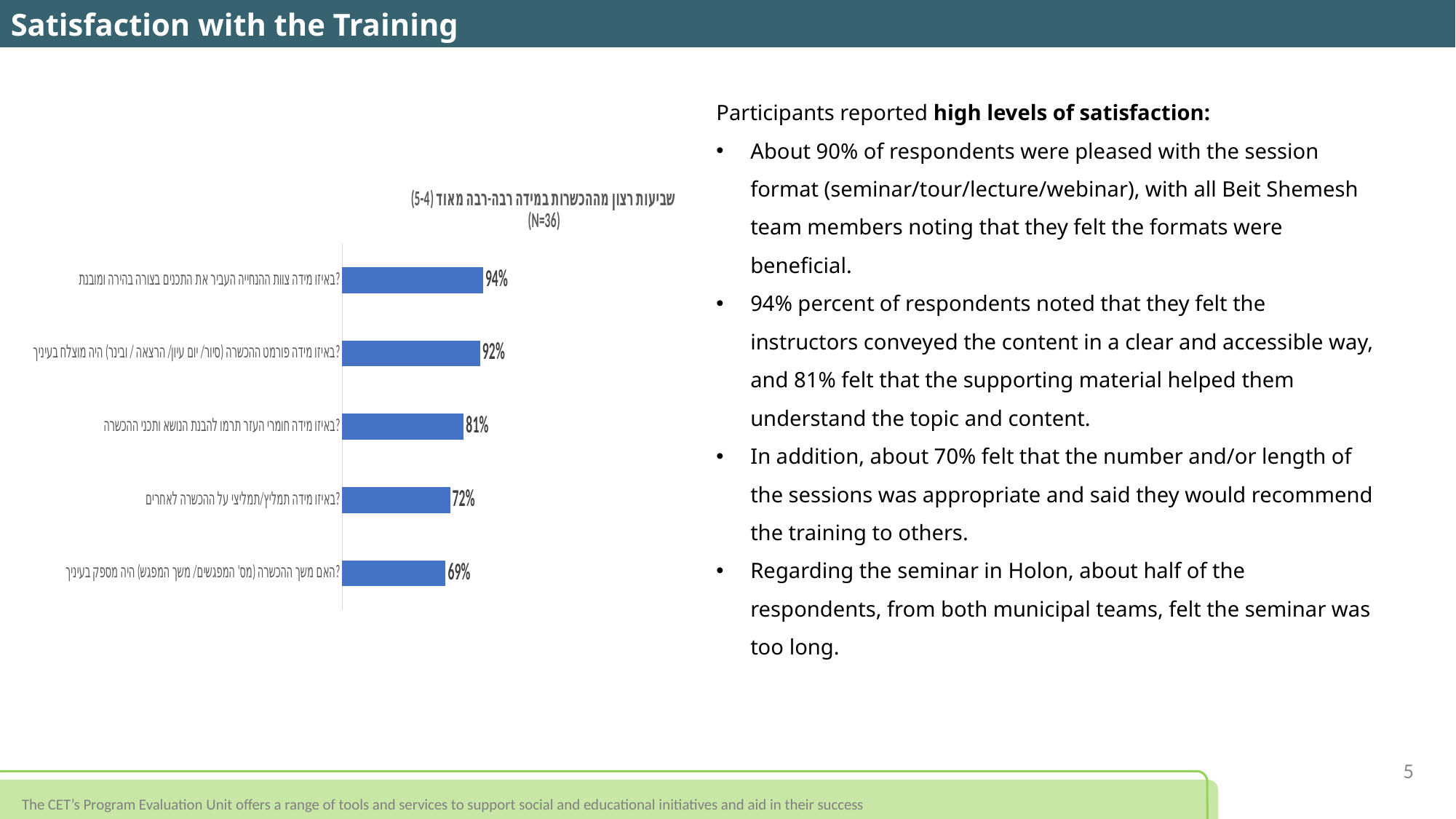
Which bar has the lowest value in the chart? The bottom bar (משך ההכשרה), 69% How many bars (categories) does the chart show? 5 What sample size (N) is stated in the chart title? N=36 What is the value of the bar for the supporting materials question (חומרי העזר)? 81% Which is larger: the value for the supporting materials question (חומרי העזר) or the value for recommending the training (תמליץ/תמליצי)? Supporting materials (81%) What type of chart is shown on the slide? Bar chart What is the value of the bar for recommending the training to others (תמליץ/תמליצי על ההכשרה לאחרים)? 72% What is the value of the bottom bar in the chart (the question about the length of the training, משך ההכשרה)? 69% What is the value of the bar for the training format question (פורמט ההכשרה)? 92% What is the value of the top bar in the chart (the question about the instructors conveying the content clearly, צוות ההנחייה)? 94% What is the difference between the highest bar (94%) and the lowest bar (69%) in the chart? 25 percentage points Which bar has the highest value in the chart? The top bar (צוות ההנחייה העביר את התכנים בצורה בהירה ומובנת), 94%